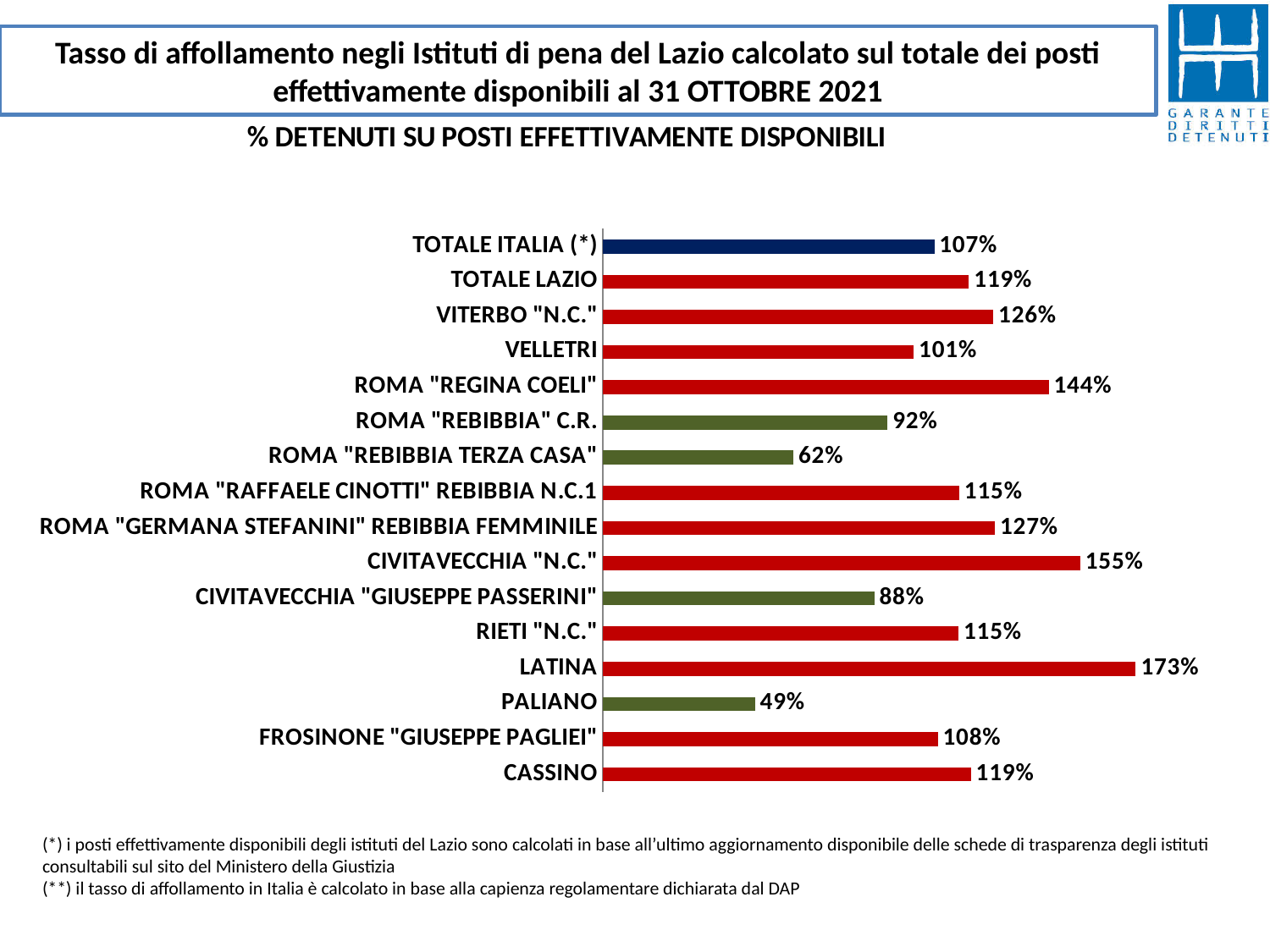
Which category has the highest value? LATINA What is the title of the chart? % DETENUTI SU POSTI EFFETTIVAMENTE DISPONIBILI What is the value for TOTALE ITALIA (*)? 107% Which category has the lowest value? PALIANO What is the value for LATINA? 173% What is the difference between the values for CIVITAVECCHIA "N.C." and ROMA "REBIBBIA TERZA CASA"? 93% What is the value for CIVITAVECCHIA "GIUSEPPE PASSERINI"? 88% Which is larger, the value for VITERBO "N.C." or the value for VELLETRI? VITERBO "N.C." How many categories are shown in the chart? 16 What is the value for ROMA "REGINA COELI"? 144% What kind of chart is shown on the slide? Bar chart What is the difference between the values for TOTALE LAZIO and TOTALE ITALIA (*)? 12%